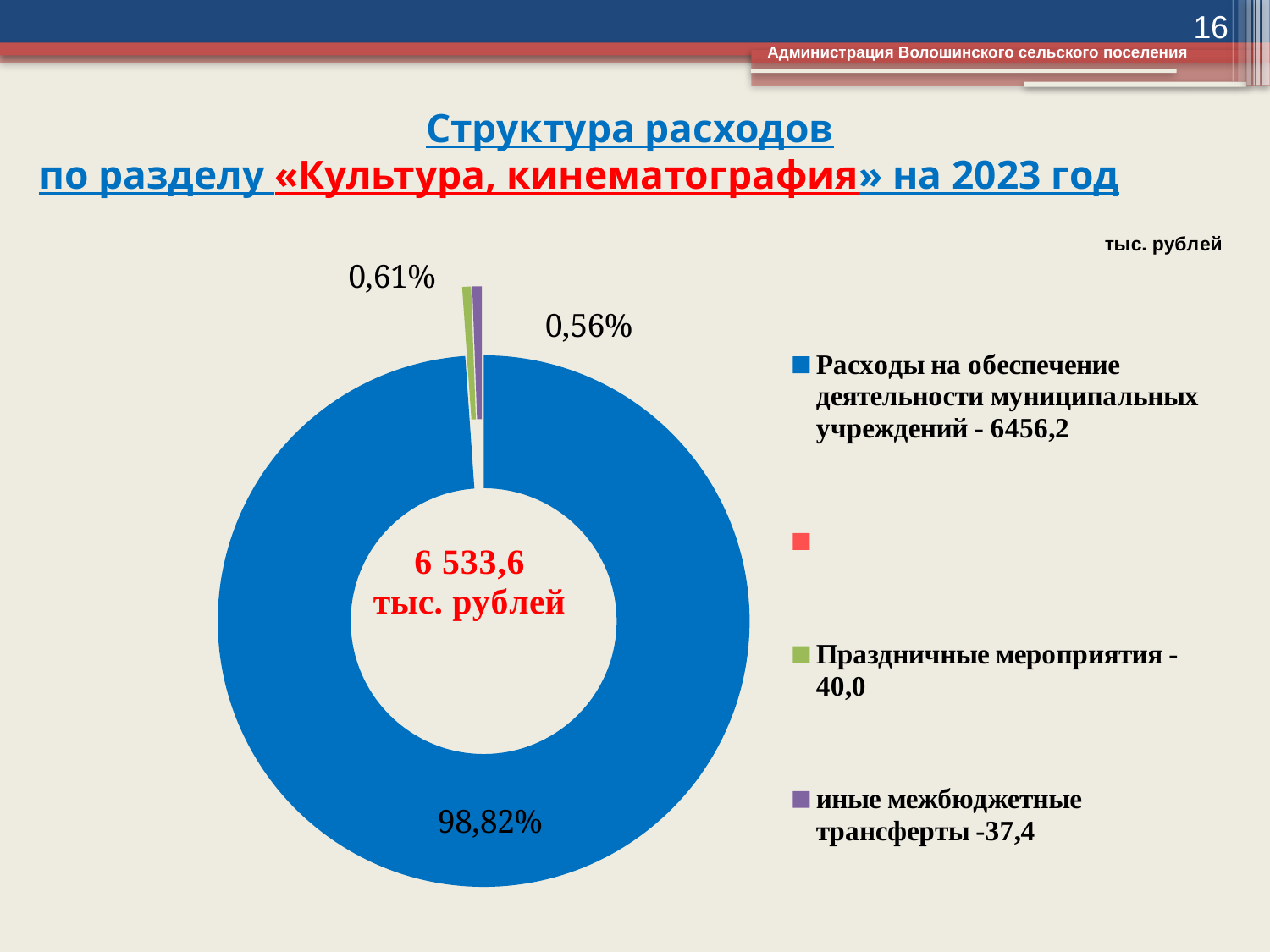
Which category has the smallest share of the pie? иные межбюджетные трансферты What total amount is printed in the centre of the doughnut chart? 6 533,6 тыс. рублей What share of expenses is shown for «иные межбюджетные трансферты»? 0,56% What share of expenses is shown for «Праздничные мероприятия»? 0,61% How many slices of the pie have a percentage label? 3 Which category has the largest share of the pie? Расходы на обеспечение деятельности муниципальных учреждений What share of expenses is shown for «Расходы на обеспечение деятельности муниципальных учреждений»? 98,82% Which is larger: the share for «Праздничные мероприятия» or the share for «иные межбюджетные трансферты»? Праздничные мероприятия According to the legend, what amount (тыс. рублей) is given for «иные межбюджетные трансферты»? 37,4 According to the legend, what amount (тыс. рублей) is given for «Праздничные мероприятия»? 40,0 What is the difference in percentage points between the share for «Праздничные мероприятия» and the share for «иные межбюджетные трансферты»? 0,05 What kind of chart is shown on the slide? pie chart (doughnut)